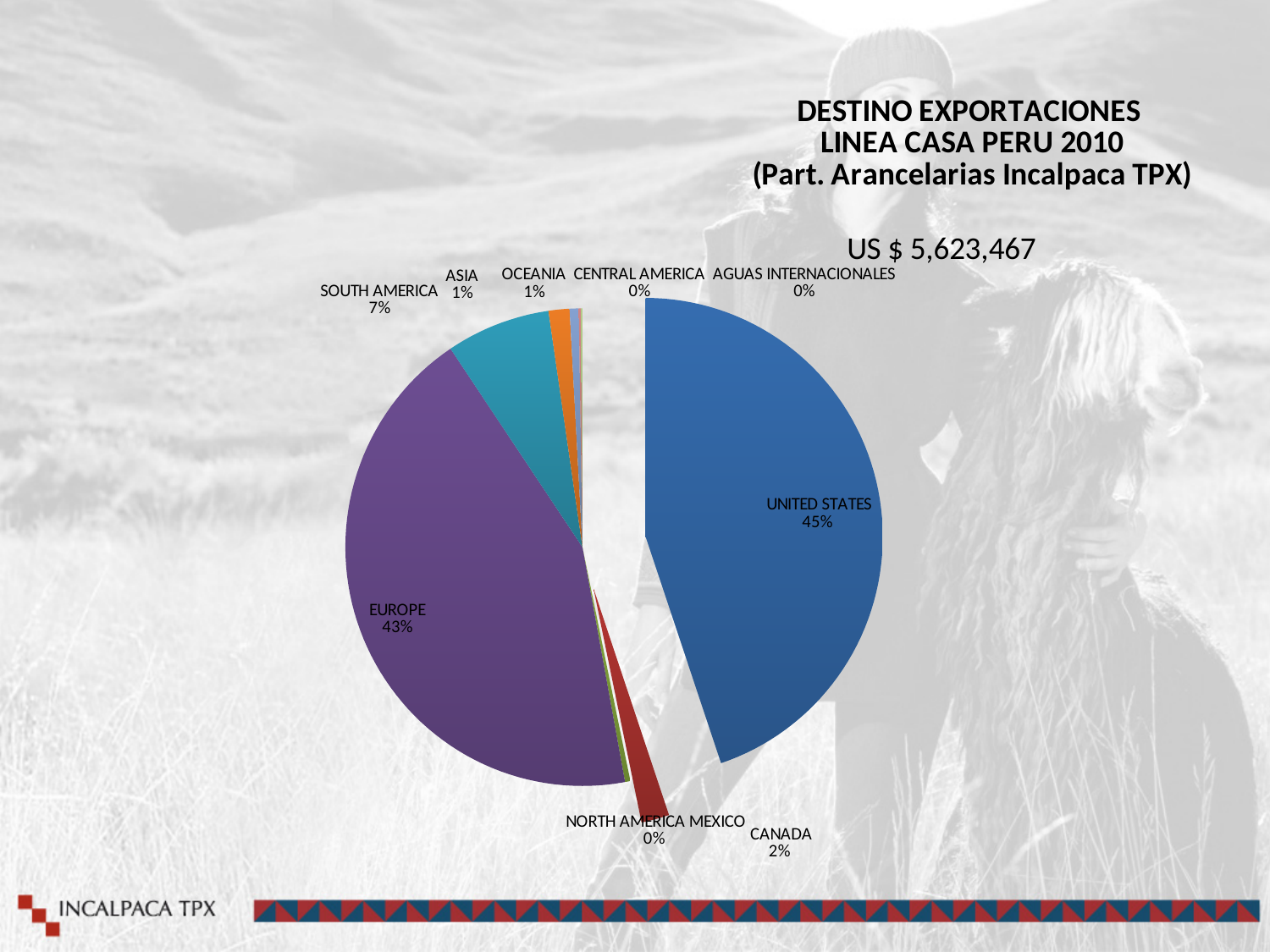
What share of exports went to ASIA? 1% What total export value is shown above the pie chart? US $ 5,623,467 How many destination categories are shown in the pie chart? 9 What share of exports went to UNITED STATES? 45% Which destination has the largest share of exports? UNITED STATES What share of exports went to SOUTH AMERICA? 7% What kind of chart is shown on the slide? Pie chart What is the difference between the shares for UNITED STATES and EUROPE? 2% Which is larger, the share for EUROPE or the share for SOUTH AMERICA? EUROPE What year is named in the chart title? 2010